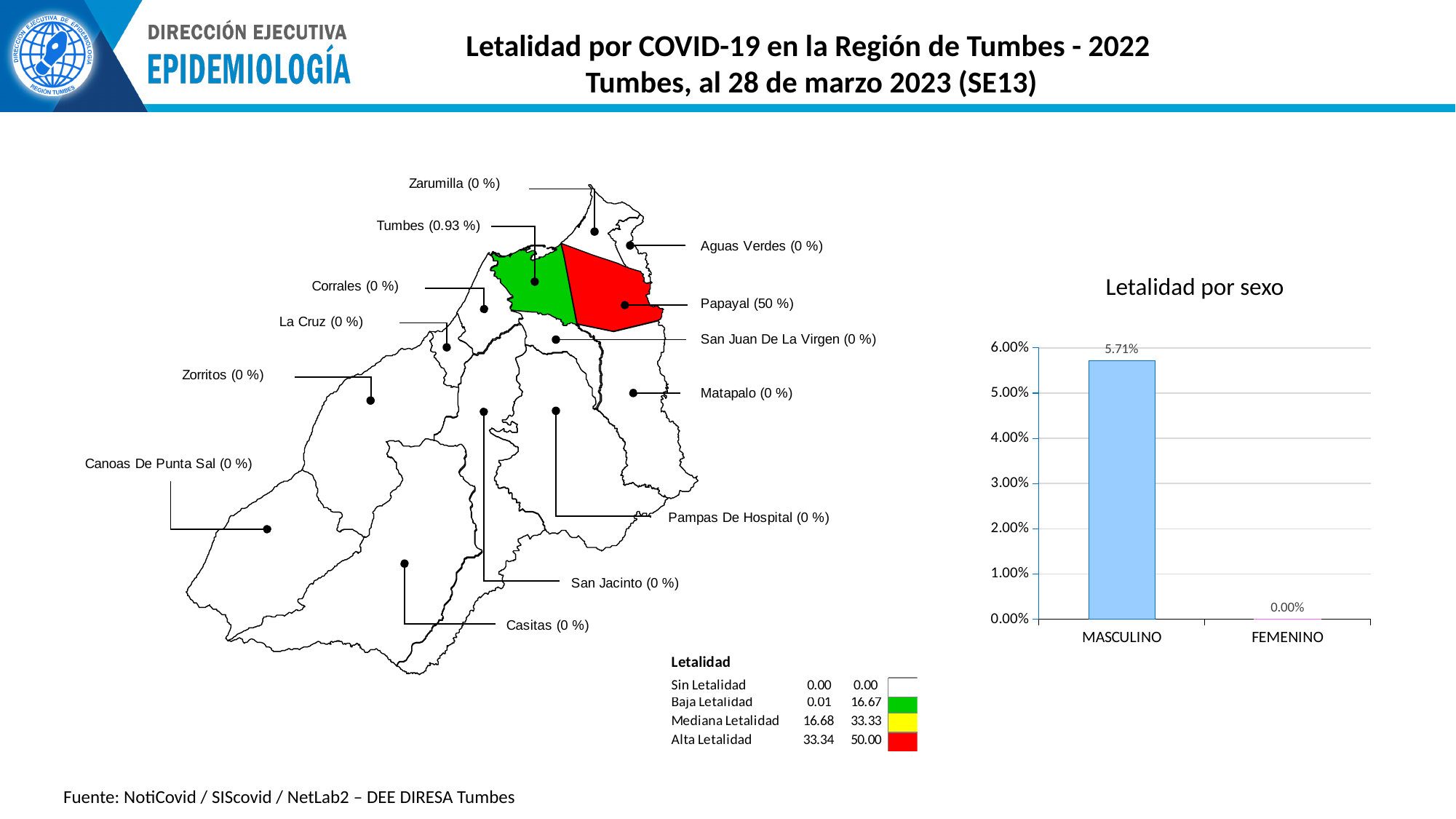
In the 'Letalidad por sexo' chart, what is the value for FEMENINO? 0.00% What kind of chart is the 'Letalidad por sexo' chart? bar chart In the 'Letalidad por sexo' chart, which category has the highest value? MASCULINO In the 'Letalidad por sexo' chart, is the value for MASCULINO greater or less than 5.00%? greater In the 'Letalidad por sexo' chart, which category has the lowest value? FEMENINO How many categories are shown in the 'Letalidad por sexo' chart? 2 In the 'Letalidad por sexo' chart, what is the highest value shown on the vertical axis? 6.00% On the map on the left, what lethality value is shown for Tumbes? 0.93 % In the 'Letalidad por sexo' chart, what is the value for MASCULINO? 5.71% What is the title of the chart on the right side of the slide? Letalidad por sexo On the map on the left, what lethality value is shown for Papayal? 50 % In the 'Letalidad por sexo' chart, what is the difference between the MASCULINO and FEMENINO values? 5.71%